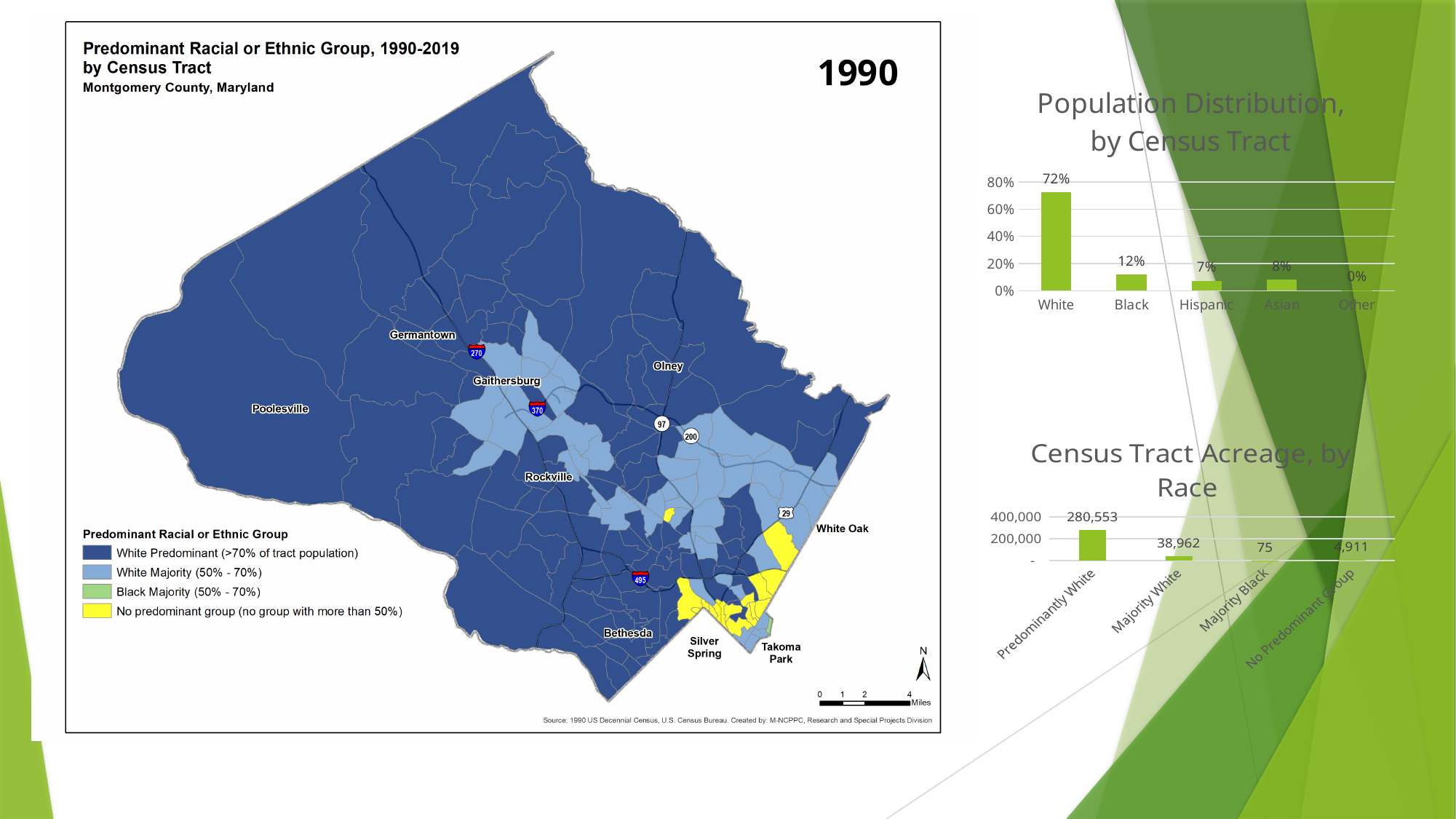
In the 'Population Distribution, by Census Tract' chart, what is the value for Black? 12% In the 'Census Tract Acreage, by Race' chart, what is the difference between the values for Majority White and No Predominant Group? 34,051 How many categories are shown in the 'Population Distribution, by Census Tract' chart? 5 What kind of chart is the 'Census Tract Acreage, by Race' chart? Bar chart In the 'Population Distribution, by Census Tract' chart, what is the difference between the values for White and Black? 60% In the 'Population Distribution, by Census Tract' chart, which is larger, the value for Hispanic or the value for Asian? Asian In the 'Census Tract Acreage, by Race' chart, which category has the lowest value? Majority Black In the 'Census Tract Acreage, by Race' chart, what is the value for Predominantly White? 280,553 In the 'Population Distribution, by Census Tract' chart, what is the value for White? 72% In the 'Census Tract Acreage, by Race' chart, what is the value for Majority Black? 75 In the 'Population Distribution, by Census Tract' chart, which category has the lowest value? Other In the 'Population Distribution, by Census Tract' chart, which category has the highest value? White